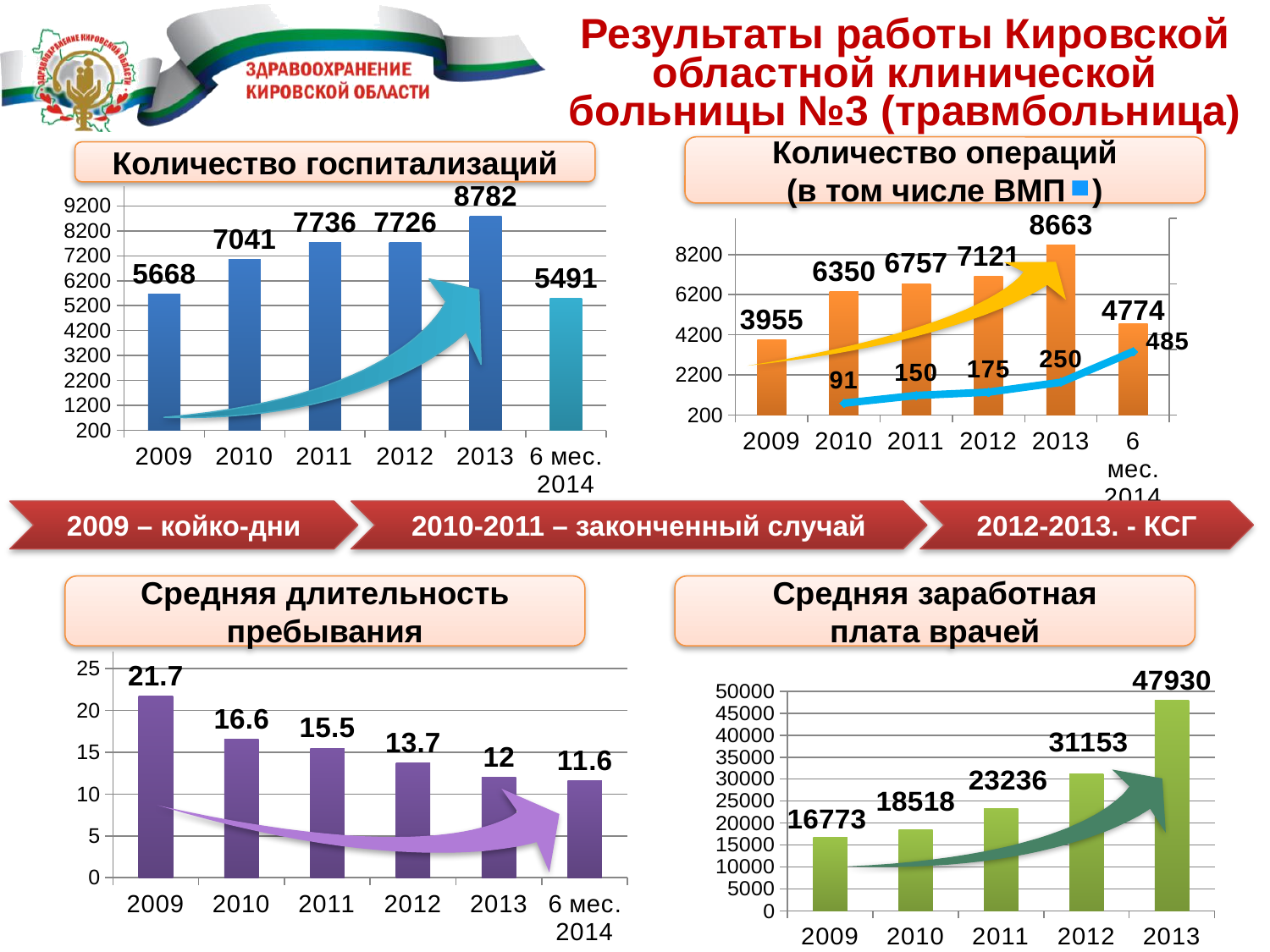
In the chart 'Количество госпитализаций', which year has the lowest value among the full years 2009–2013? 2009 In the chart 'Средняя длительность пребывания', what is the value for 2011? 15.5 In the chart 'Средняя заработная плата врачей', what is the value for 2011? 23236 In the chart 'Средняя заработная плата врачей', what is the difference between the values for 2013 and 2012? 16777 In the chart 'Средняя длительность пребывания', how many categories are shown on the x axis? 6 What kind of chart is 'Средняя заработная плата врачей'? bar chart In the chart 'Количество операций (в том числе ВМП)', which year has the highest number of operations? 2013 In the chart 'Средняя длительность пребывания', do the values rise or fall from 2009 to 6 мес. 2014? fall In the chart 'Количество госпитализаций', what is the value for 2013? 8782 In the chart 'Количество операций (в том числе ВМП)', what is the ВМП value for 6 мес. 2014? 485 In the chart 'Количество госпитализаций', what is the difference between the values for 2013 and 2009? 3114 In the chart 'Количество операций (в том числе ВМП)', what is the number of operations for 2012? 7121